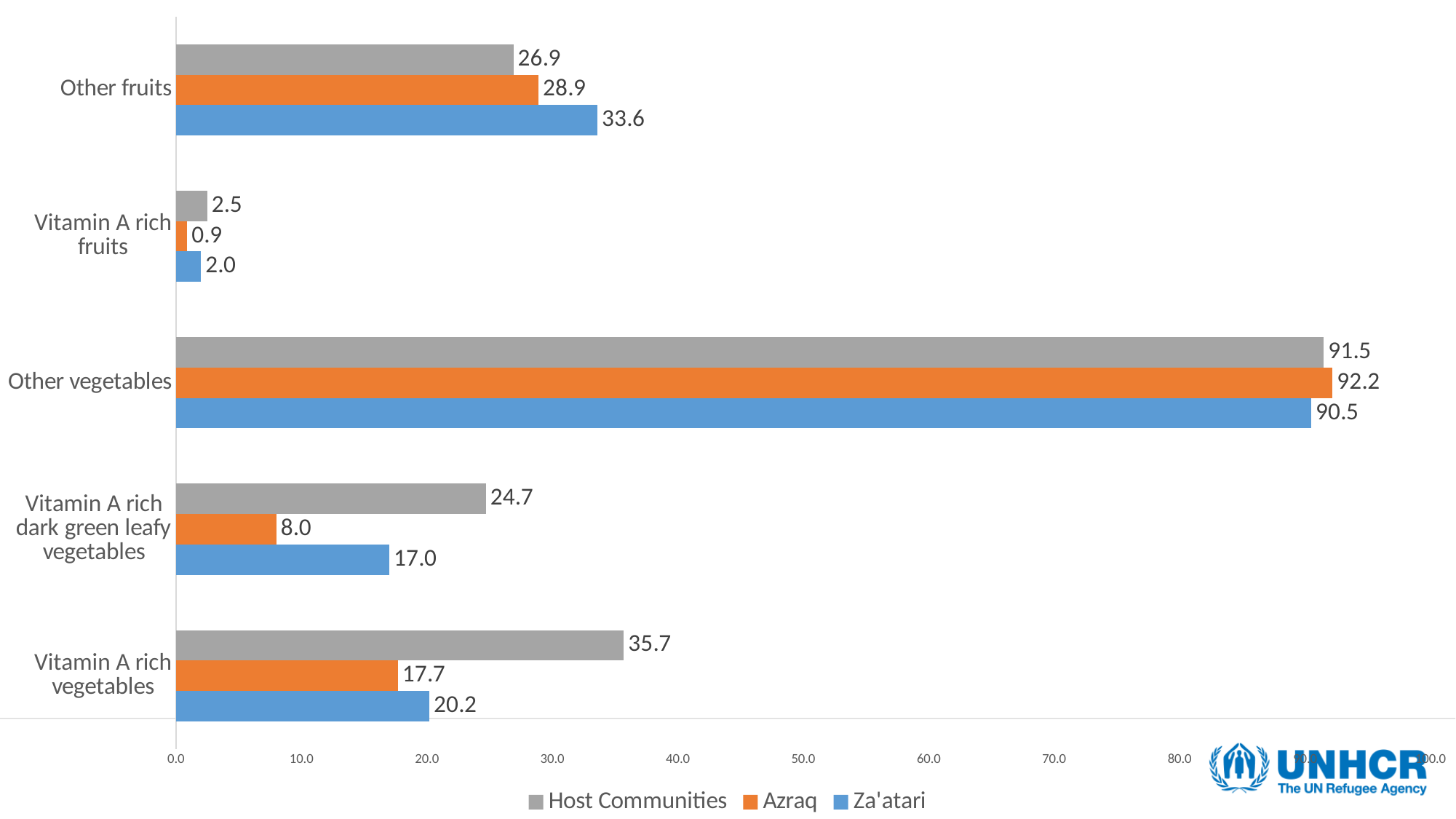
What is the value for Host Communities in the Vitamin A rich vegetables category? 35.7 What is the value for Azraq in the Vitamin A rich dark green leafy vegetables category? 8.0 What is the value for Za'atari in the Other fruits category? 33.6 What is the difference between the Host Communities and Azraq values for Vitamin A rich vegetables? 18.0 Is the value for Za'atari in the Other vegetables category greater or less than 80.0? greater How many categories are shown on the chart? 5 Which is larger for Vitamin A rich dark green leafy vegetables: the Host Communities value or the Za'atari value? Host Communities How many series does the legend list? 3 Which category has the highest value for Azraq? Other vegetables Which colour represents Azraq in the chart? Orange Which category has the lowest value for Host Communities? Vitamin A rich fruits What kind of chart is shown on the slide? Bar chart